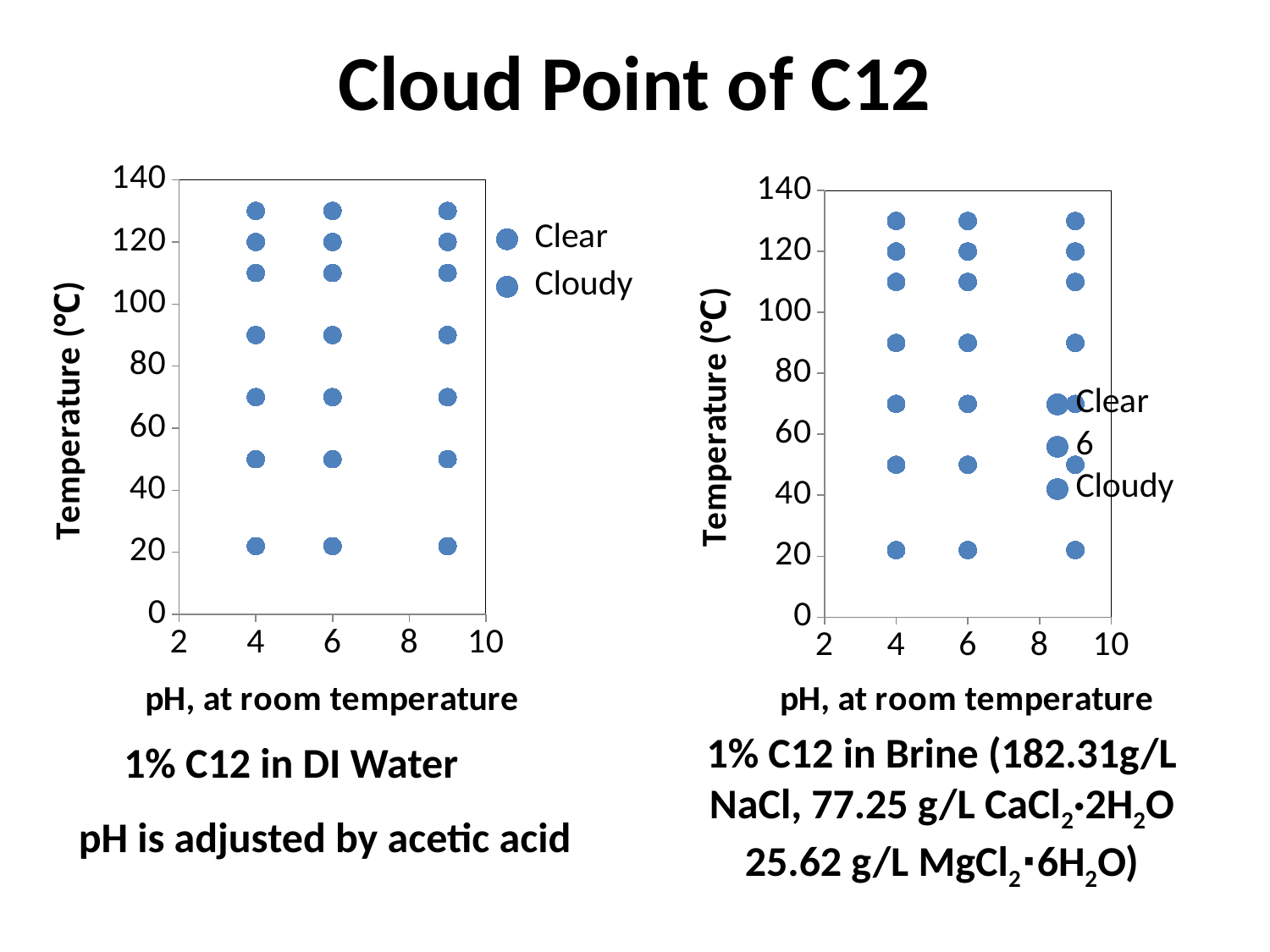
What is the maximum value shown on the x-axis of the left chart (1% C12 in DI Water)? 10 On the left chart (1% C12 in DI Water), is the temperature of the lowest plotted point greater or less than 40? less On the left chart (1% C12 in DI Water), how many data points are plotted in total? 21 On the right chart (1% C12 in Brine), is the temperature of the highest plotted point greater or less than 140? less What are the legend entries on the left chart (1% C12 in DI Water)? Clear, Cloudy On the right chart (1% C12 in Brine), how many distinct temperature levels have data points plotted? 7 What kind of chart is the left chart, 1% C12 in DI Water? Scatter chart How many series does the legend of the left chart (1% C12 in DI Water) list? 2 On the left chart (1% C12 in DI Water), is the temperature of the highest plotted point greater or less than 120? greater What is the y-axis title of the right chart (1% C12 in Brine)? Temperature (°C) On the left chart (1% C12 in DI Water), how many distinct pH values have data points plotted? 3